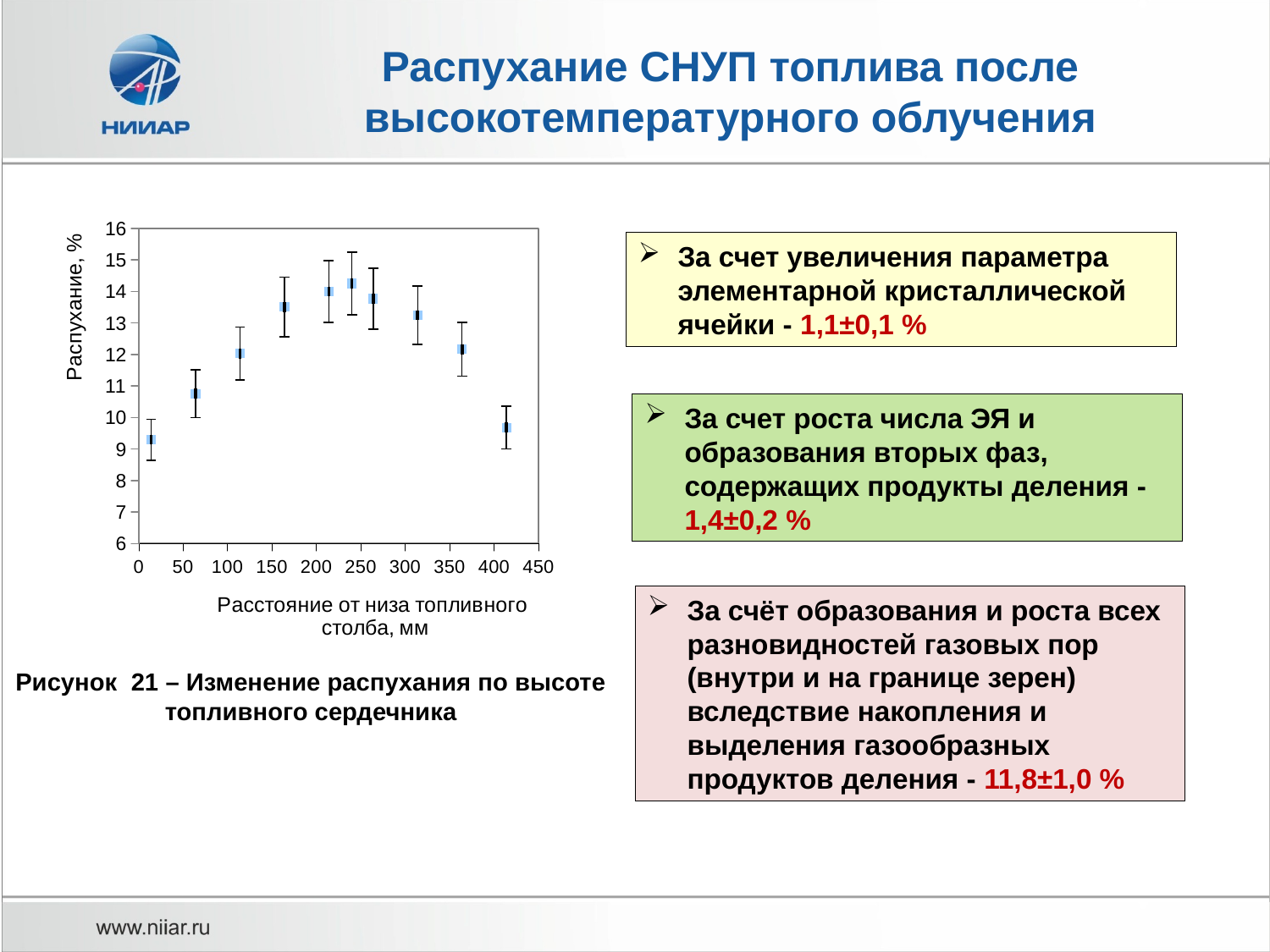
What is the maximum value shown on the vertical axis of the chart? 16 What is the label of the vertical axis of the chart? Распухание, % How does the swelling change as the distance from the bottom of the fuel column increases from 0 to 450 mm? rises to a peak around 200–250 mm, then falls Which point has the larger swelling value: the one near 65 mm or the one near 165 mm? the one near 165 mm How many data points are plotted on the chart? 10 What is the label of the horizontal axis of the chart? Расстояние от низа топливного столба, мм Is the swelling value for the point near 415 mm greater or less than 11%? less Is the swelling value for the point nearest 0 mm greater or less than 10%? less Is the swelling value for the point near 115 mm greater or less than 11%? greater What kind of chart is shown on the slide? scatter chart with error bars